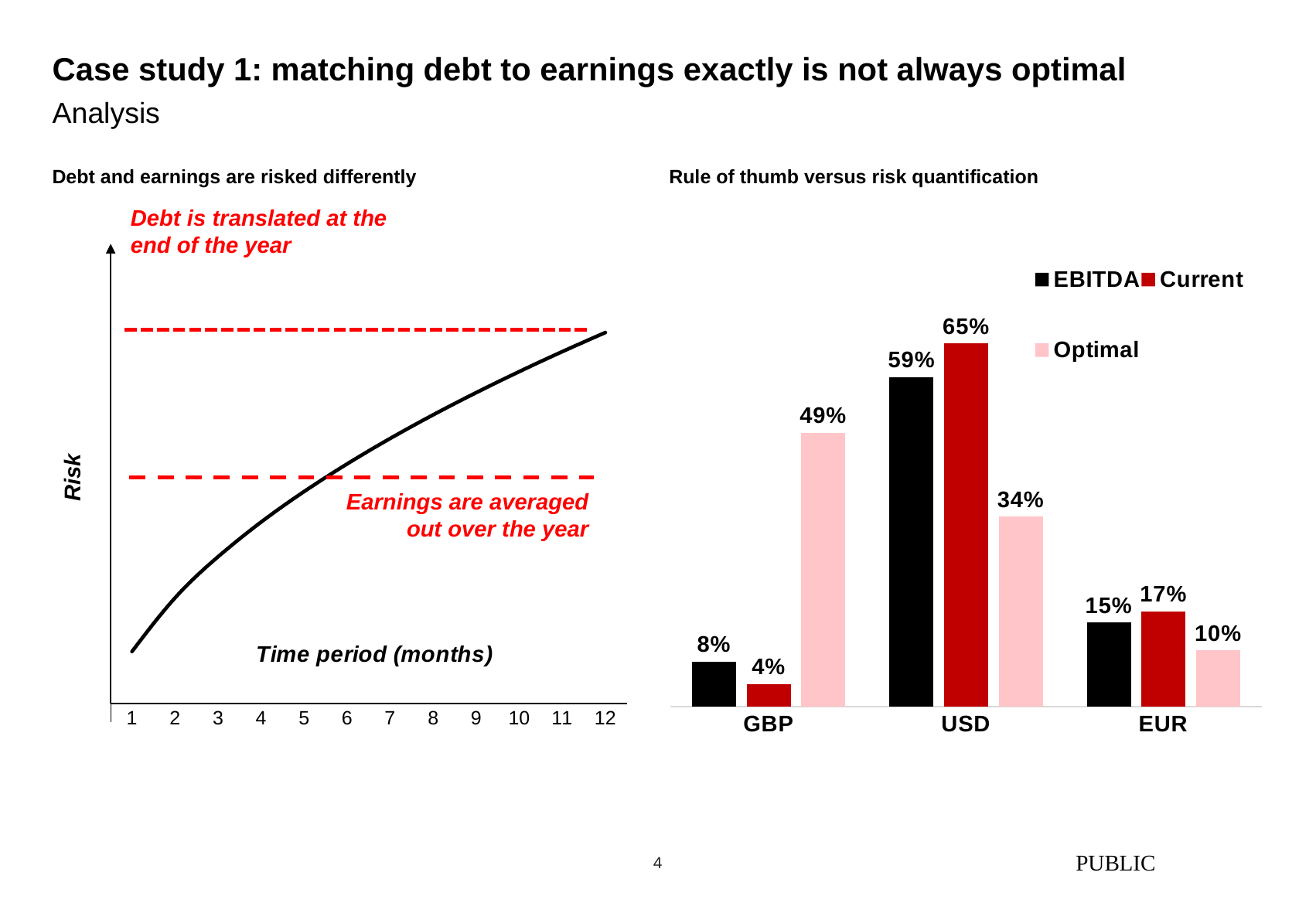
In the 'Rule of thumb versus risk quantification' chart, what is the difference between the Optimal and Current values for GBP? 45% In the 'Rule of thumb versus risk quantification' chart, which currency has the lowest Optimal value? EUR In the 'Rule of thumb versus risk quantification' chart, what is the Current value for USD? 65% In the 'Debt and earnings are risked differently' chart, does the Risk curve rise or fall as the time period increases from month 1 to month 12? Rises In the 'Rule of thumb versus risk quantification' chart, which currency has the highest Current value? USD In the 'Rule of thumb versus risk quantification' chart, what is the difference between the Current and Optimal values for USD? 31% How many series does the legend of the 'Rule of thumb versus risk quantification' chart list? 3 What kind of chart is the 'Rule of thumb versus risk quantification' chart? Bar chart In the 'Rule of thumb versus risk quantification' chart, what is the Optimal value for GBP? 49% In the 'Rule of thumb versus risk quantification' chart, what is the EBITDA value for EUR? 15% How many currency categories are shown on the x axis of the 'Rule of thumb versus risk quantification' chart? 3 In the 'Rule of thumb versus risk quantification' chart, which is larger for EUR: the EBITDA value or the Current value? Current